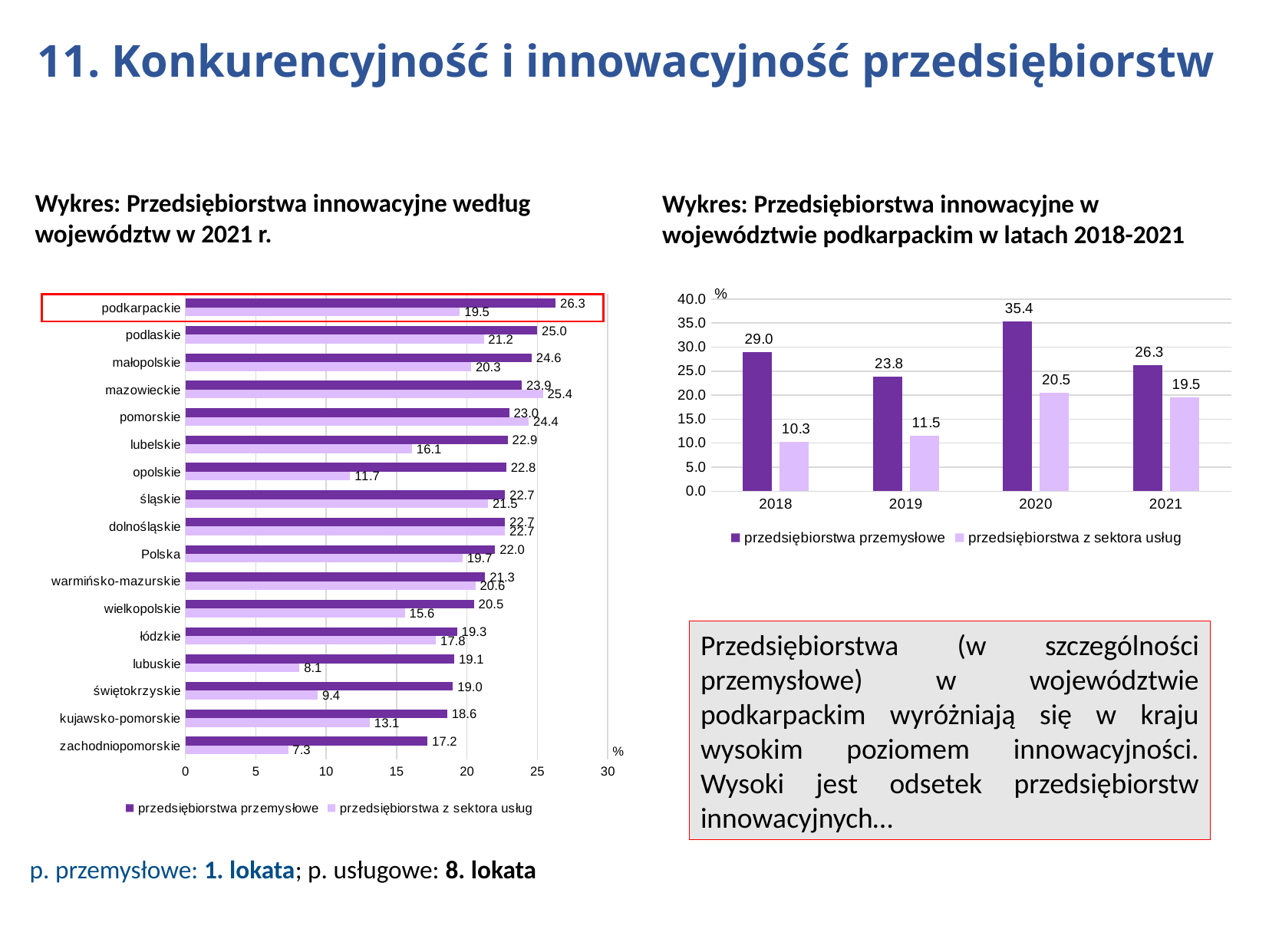
In the left chart (Przedsiębiorstwa innowacyjne według województw w 2021 r.), how many categories are shown on the vertical axis? 17 In the left chart (Przedsiębiorstwa innowacyjne według województw w 2021 r.), which is larger for pomorskie: przedsiębiorstwa przemysłowe or przedsiębiorstwa z sektora usług? przedsiębiorstwa z sektora usług In the right chart (Przedsiębiorstwa innowacyjne w województwie podkarpackim w latach 2018-2021), how many series does the legend list? 2 What kind of chart is the right chart (Przedsiębiorstwa innowacyjne w województwie podkarpackim w latach 2018-2021)? bar chart In the right chart (Przedsiębiorstwa innowacyjne w województwie podkarpackim w latach 2018-2021), what is the difference between przedsiębiorstwa przemysłowe and przedsiębiorstwa z sektora usług in 2019? 12.3 In the left chart (Przedsiębiorstwa innowacyjne według województw w 2021 r.), what is the value for przedsiębiorstwa z sektora usług in opolskie? 11.7 In the left chart (Przedsiębiorstwa innowacyjne według województw w 2021 r.), which category has the highest value for przedsiębiorstwa z sektora usług? mazowieckie In the left chart (Przedsiębiorstwa innowacyjne według województw w 2021 r.), which category has the lowest value for przedsiębiorstwa z sektora usług? zachodniopomorskie In the right chart (Przedsiębiorstwa innowacyjne w województwie podkarpackim w latach 2018-2021), what is the value for przedsiębiorstwa przemysłowe in 2020? 35.4 In the left chart (Przedsiębiorstwa innowacyjne według województw w 2021 r.), what is the value for przedsiębiorstwa przemysłowe in podkarpackie? 26.3 In the left chart (Przedsiębiorstwa innowacyjne według województw w 2021 r.), what is the difference between przedsiębiorstwa przemysłowe and przedsiębiorstwa z sektora usług in lubuskie? 11.0 In the right chart (Przedsiębiorstwa innowacyjne w województwie podkarpackim w latach 2018-2021), what is the value for przedsiębiorstwa z sektora usług in 2018? 10.3